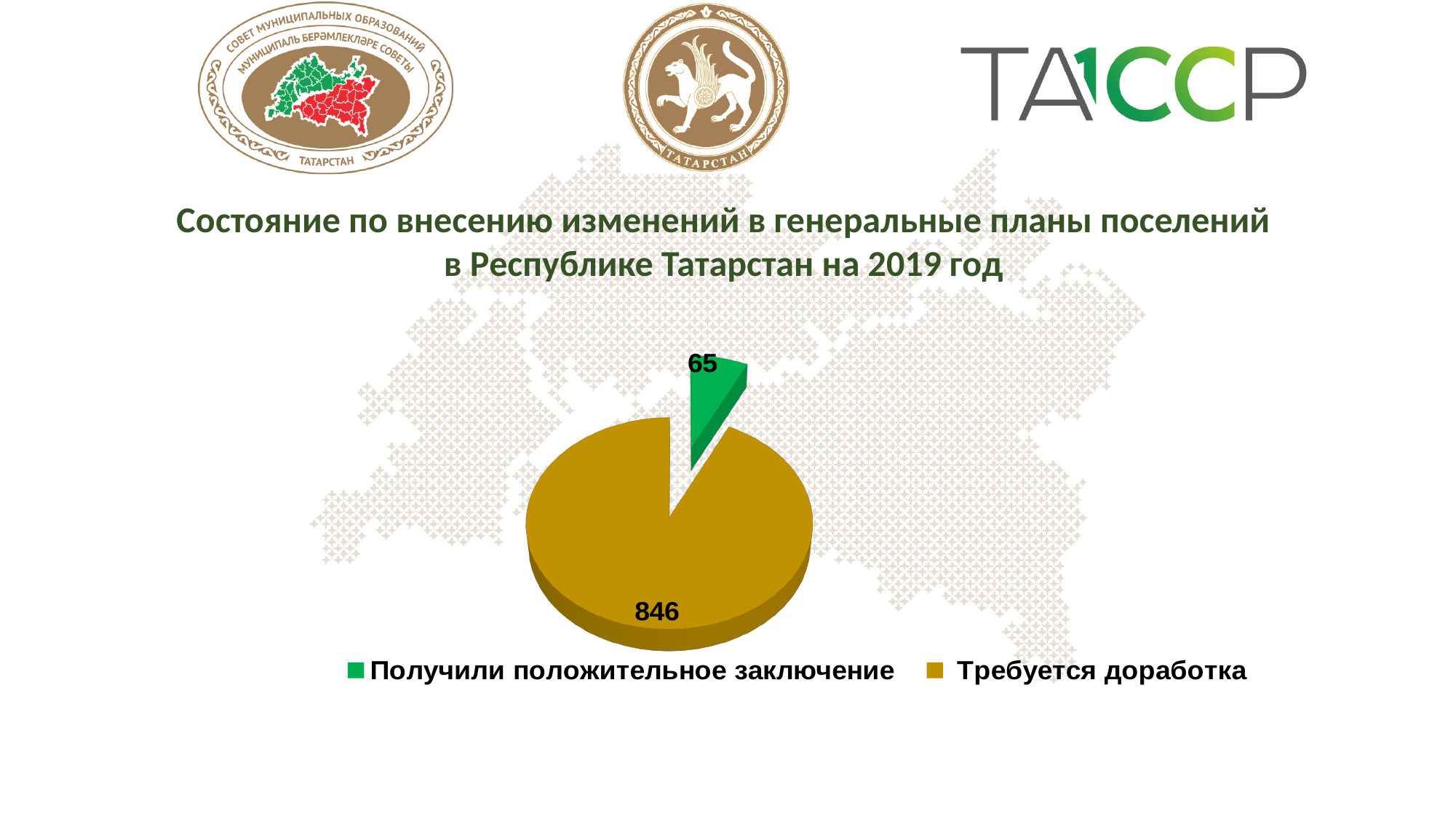
What colour is the slice for "Получили положительное заключение"? green Which is larger: the value for "Получили положительное заключение" or the value for "Требуется доработка"? Требуется доработка What is the value for "Получили положительное заключение"? 65 What is the difference between the values for "Требуется доработка" and "Получили положительное заключение"? 781 How many slices does the pie chart have? 2 What year does the chart title refer to? 2019 What is the total of the two values shown in the pie chart? 911 Which category has the largest slice of the pie? Требуется доработка What kind of chart is shown on the slide? pie chart What is the value for "Требуется доработка"? 846 Which category has the smallest slice of the pie? Получили положительное заключение How many entries does the legend list? 2